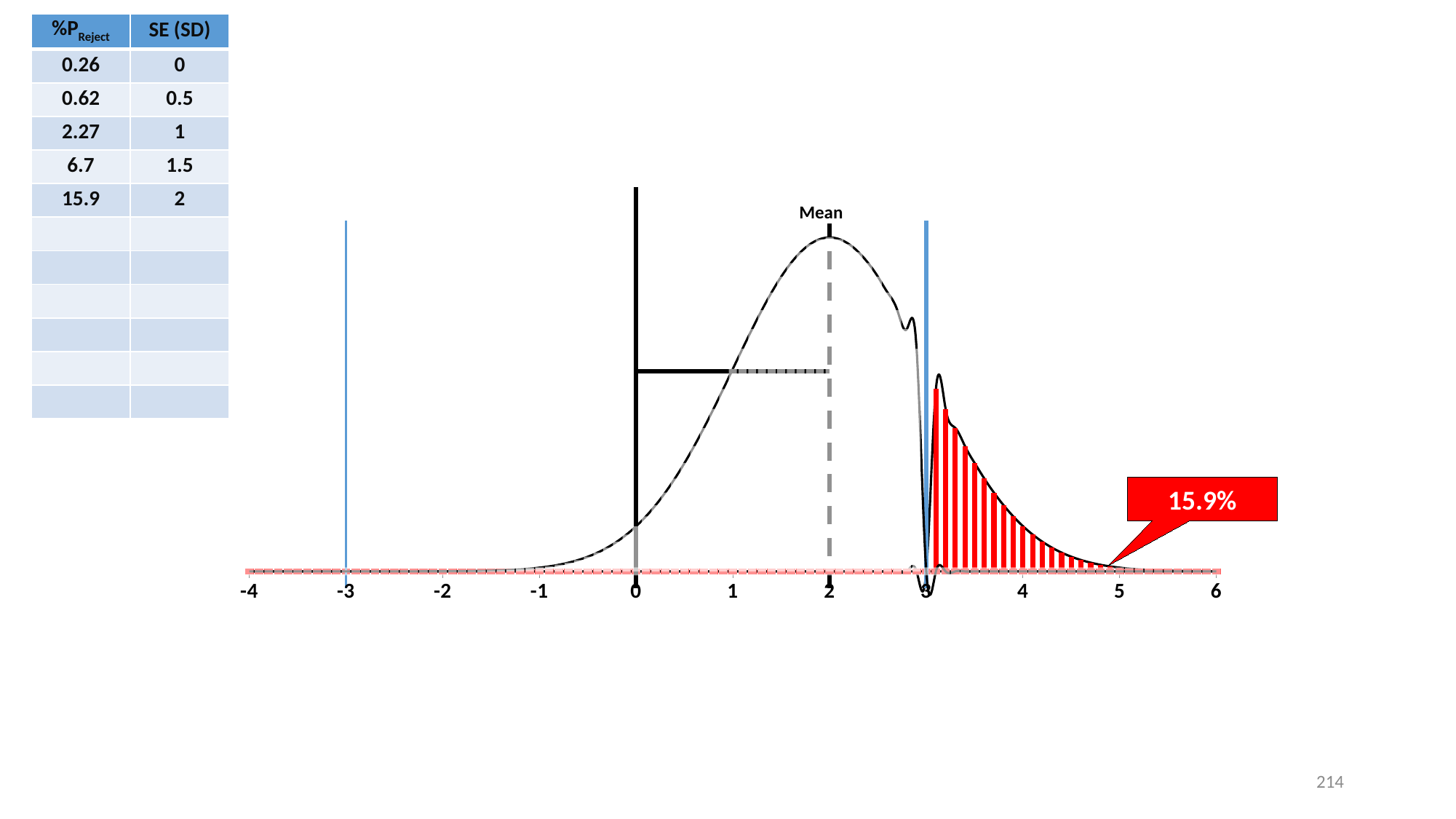
How many tick labels are shown on the x axis? 11 At what x-axis value does the red shaded region under the curve begin? 3 At what x-axis value is the dashed vertical line labelled "Mean" located? 2 What colour is the shaded area under the right tail of the curve? red What label is written above the dashed vertical line at the peak of the curve? Mean At which two x-axis values are the blue vertical lines drawn? -3 and 3 What is the highest value labelled on the x axis? 6 What percentage is shown in the red callout on the chart? 15.9% Does the curve rise or fall as x increases from 3 to 5? fall What is the lowest value labelled on the x axis? -4 What kind of chart is shown on the slide? line chart Does the curve rise or fall as x increases from 0 to 2? rise